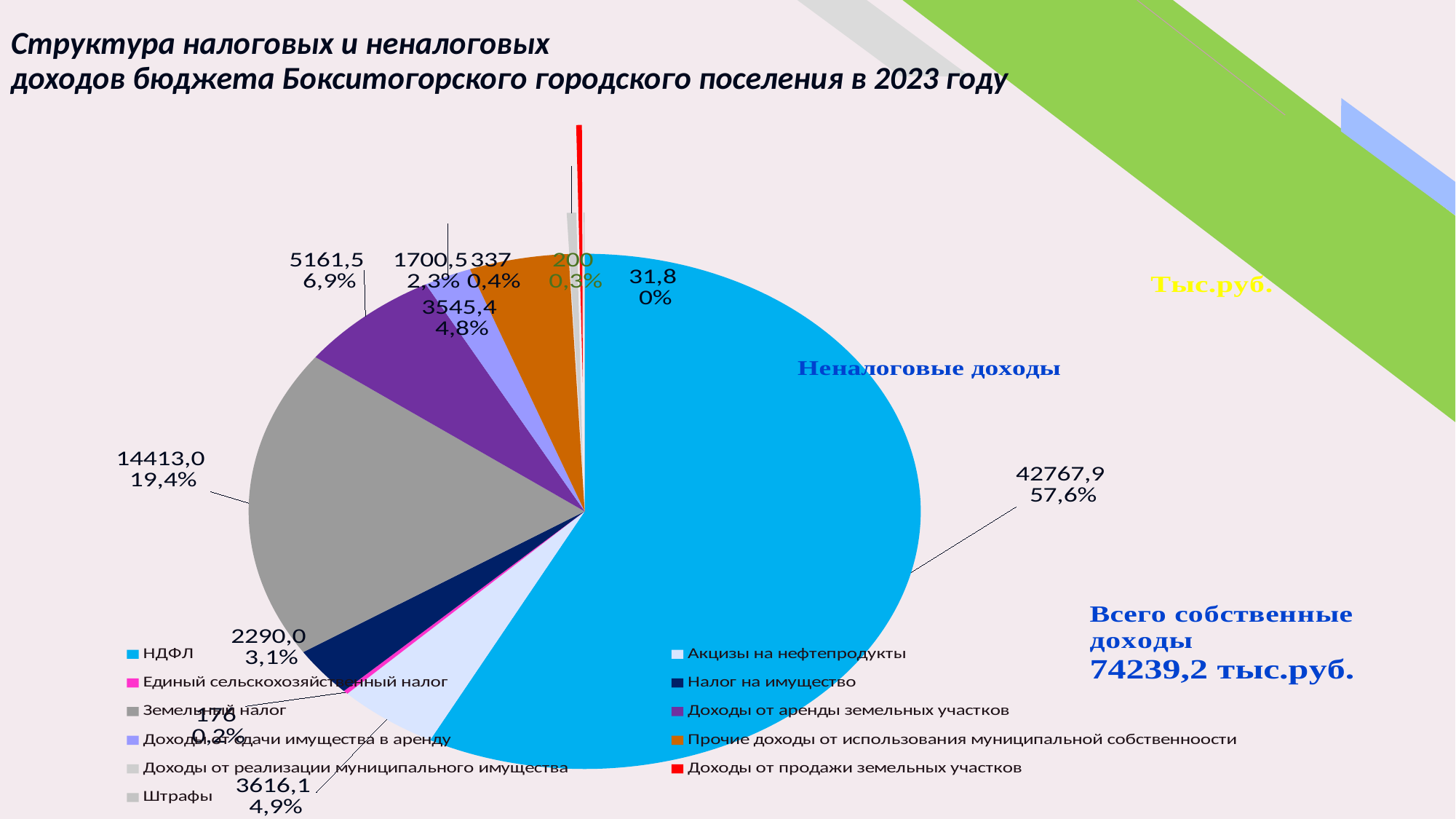
What share of the pie does НДФЛ account for? 57,6% What total for Всего собственные доходы is stated on the slide? 74239,2 тыс.руб. What share of the pie does Земельный налог account for? 19,4% What value is shown for Акцизы на нефтепродукты? 3616,1 How many categories does the legend of the pie chart list? 11 What is the difference between the values for Земельный налог and Налог на имущество? 12123,0 Which is larger: the value for Земельный налог or the value for Доходы от аренды земельных участков? Земельный налог Which category has the largest slice of the pie? НДФЛ What value is shown for Налог на имущество? 2290,0 What value is shown for НДФЛ in the pie chart? 42767,9 What kind of chart is shown on the slide? pie chart What value is shown for Земельный налог? 14413,0